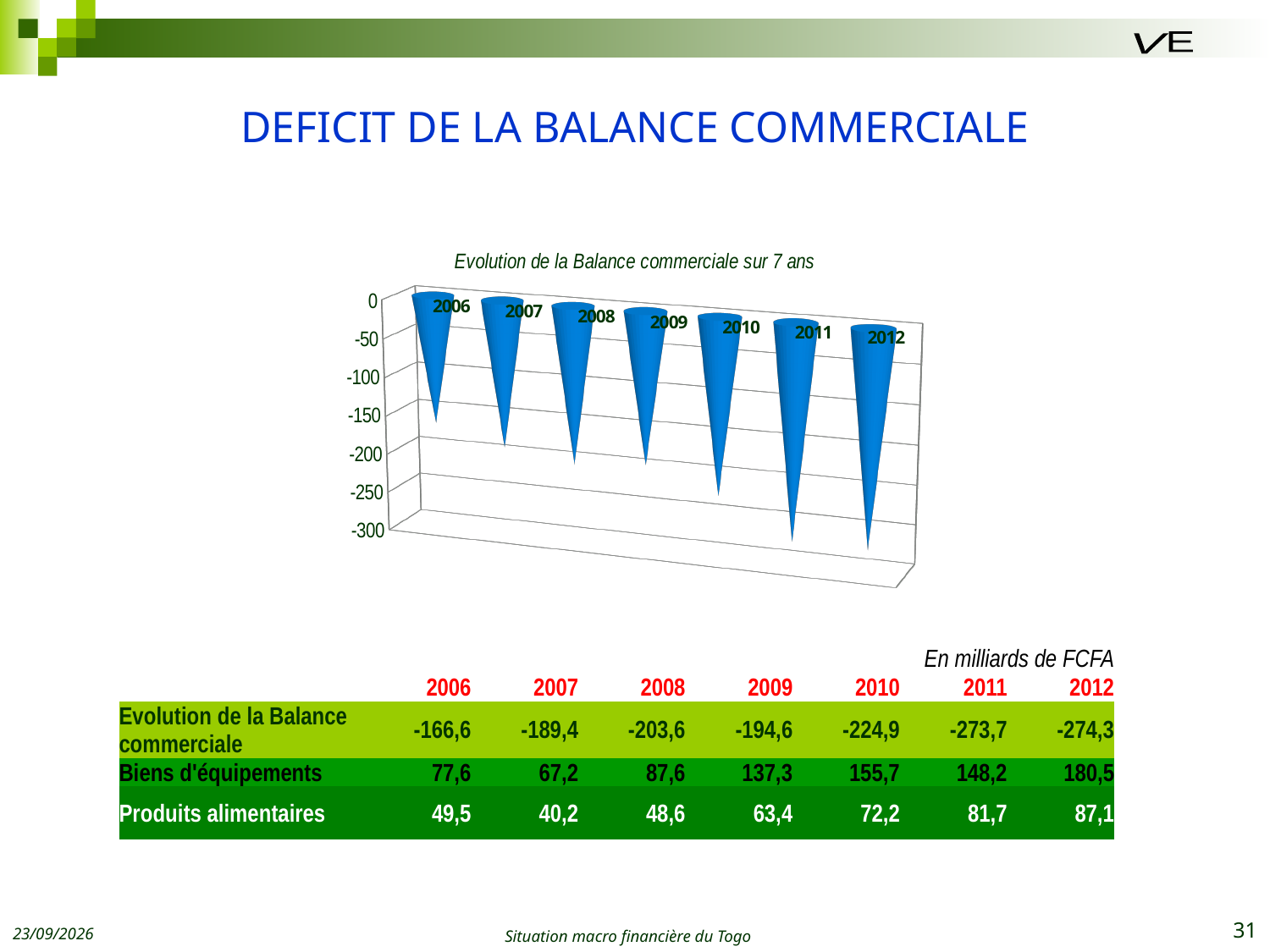
Which year has the larger trade balance value, 2008 or 2009? 2009 Is the value for 2010 greater or less than -200? less How many years are plotted on the chart? 7 Do the trade balance values generally rise or fall from 2006 to 2012? fall What is the title of the chart? Evolution de la Balance commerciale sur 7 ans What is the value of the trade balance for 2010? -224,9 What is the value of the trade balance for 2006? -166,6 Is the value for 2007 greater or less than -200? greater What is the value of the trade balance for 2012? -274,3 What is the difference between the trade balance values for 2006 and 2007? 22,8 What kind of chart is shown on the slide? bar chart Which year has the highest (least negative) trade balance on the chart? 2006